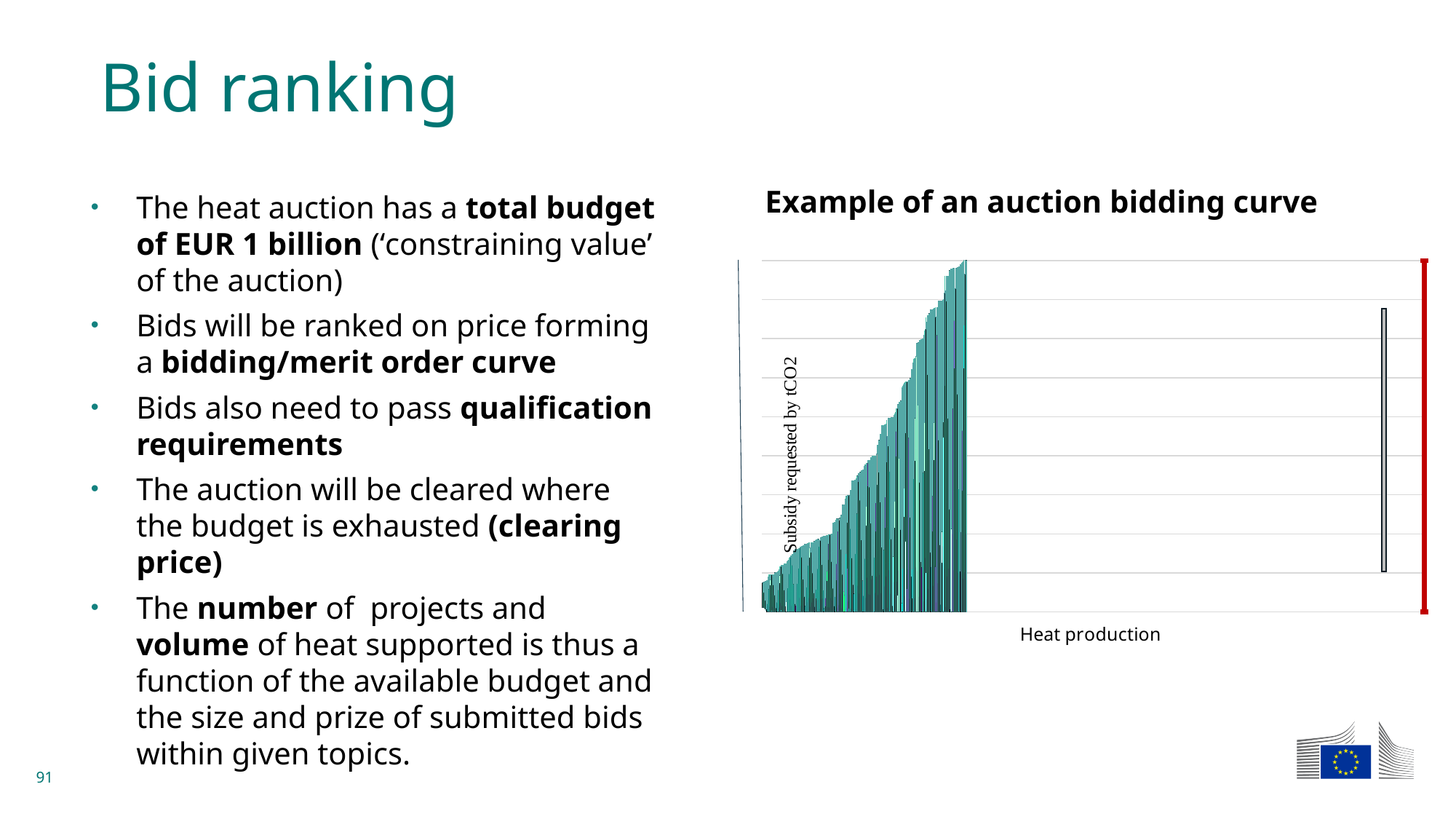
What is the title of the chart? Example of an auction bidding curve What is the label of the x axis of the chart? Heat production What kind of chart is shown on the slide? bar chart Do the bar heights rise or fall from left to right along the x axis? rise